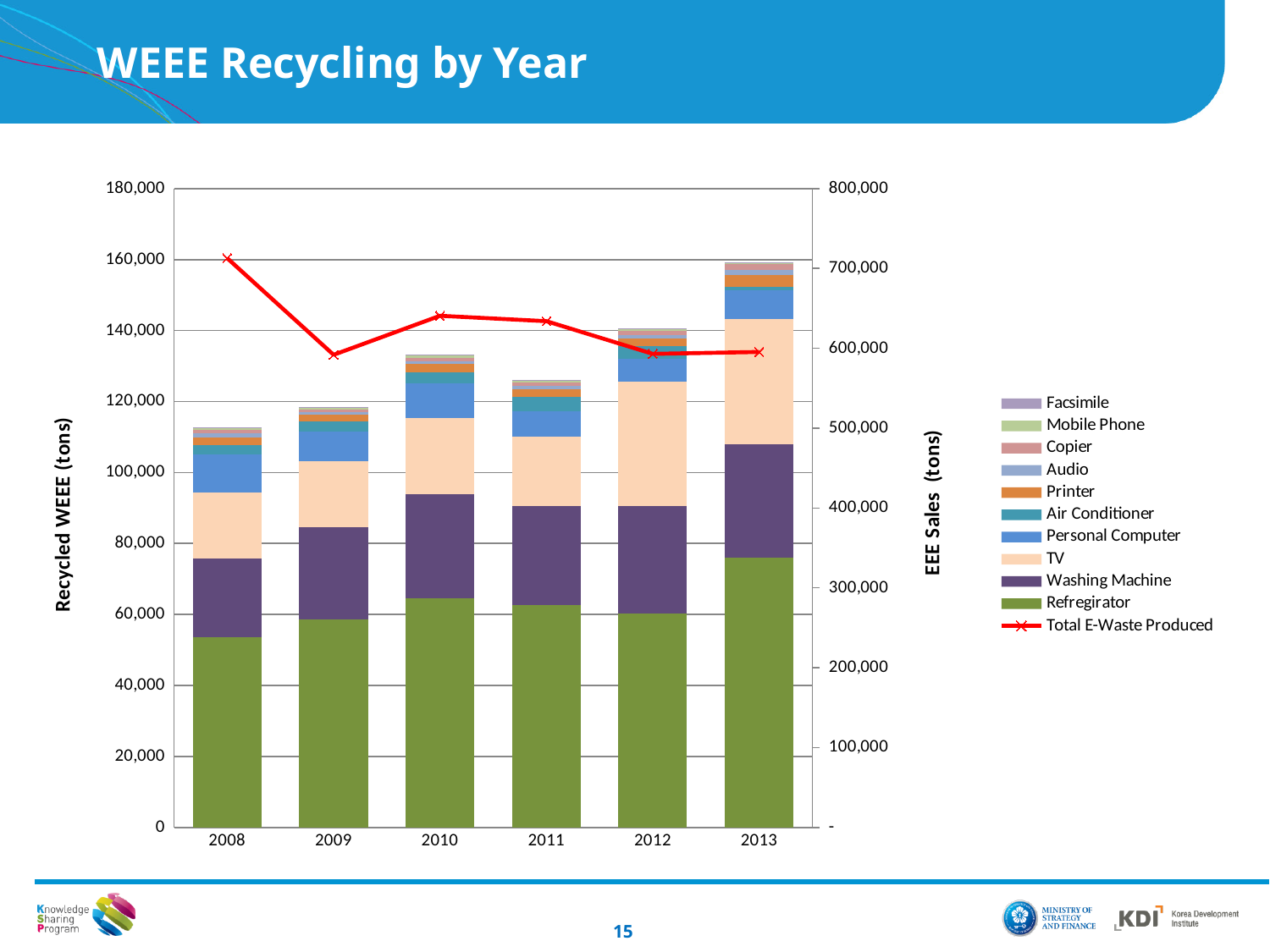
How many series does the legend list? 11 How many years are shown on the x axis? 6 In which year is the Total E-Waste Produced line at its highest? 2008 Is the total recycled WEEE for 2013 greater or less than 140,000 tons? greater Which series is plotted as a line rather than as bars? Total E-Waste Produced What kind of chart is shown on the slide? A stacked bar chart with a line Is the Refregirator segment larger in 2013 or in 2008? 2013 Does the Total E-Waste Produced line rise or fall from 2008 to 2009? fall Is the Total E-Waste Produced value for 2009 greater or less than 700,000 tons? less Is the total recycled WEEE for 2008 greater or less than 120,000 tons? less Which year has the shortest stacked bar of recycled WEEE? 2008 Which year has the tallest stacked bar of recycled WEEE? 2013